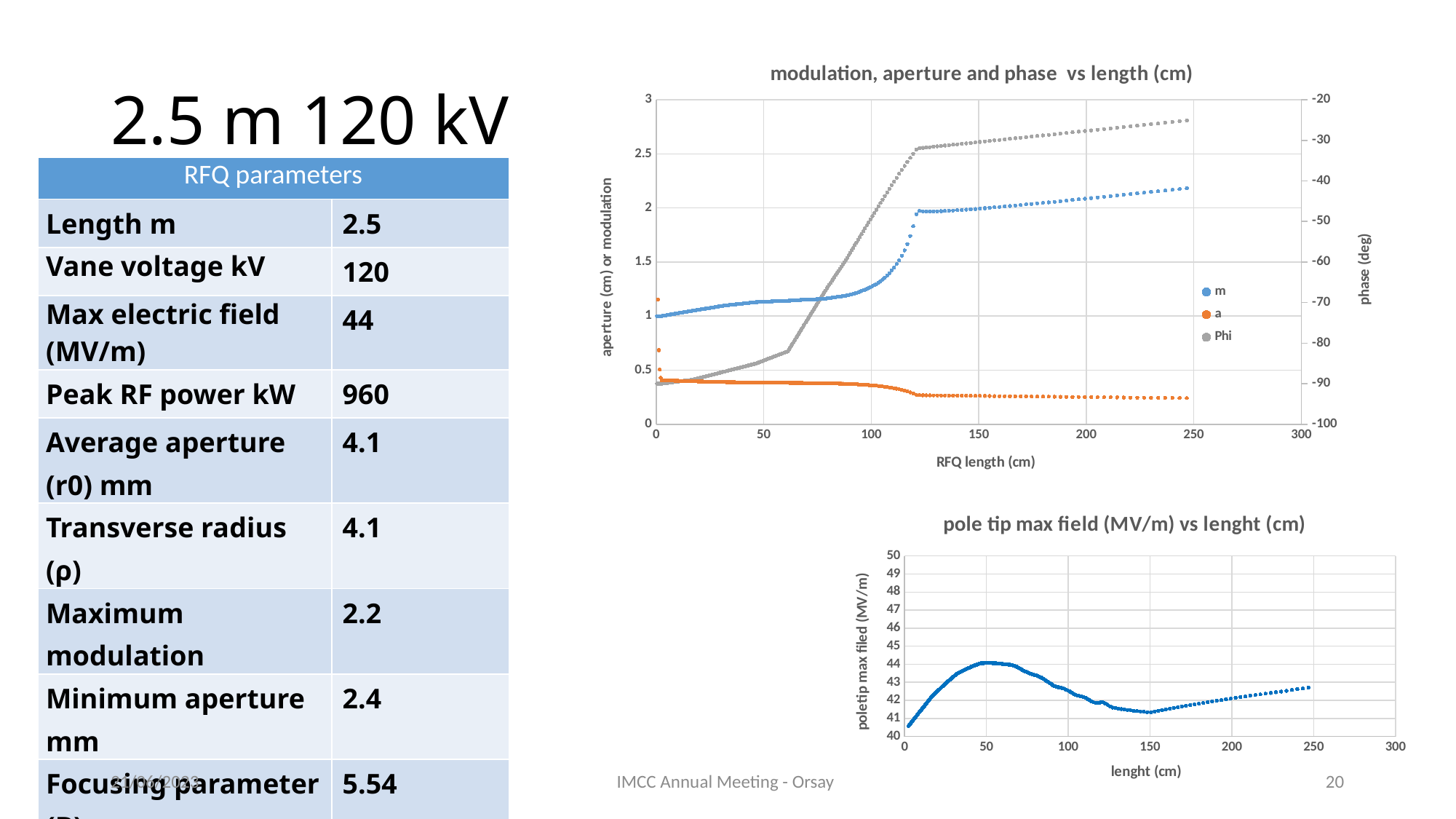
In the top chart (modulation, aperture and phase vs length), is the value of a at 250 cm greater or less than 0.5? less In the top chart (modulation, aperture and phase vs length), does the a series rise or fall as RFQ length increases? fall What kind of chart is the top chart (modulation, aperture and phase vs length)? scatter chart In the top chart (modulation, aperture and phase vs length), how many series does the legend list? 3 In the top chart (modulation, aperture and phase vs length), does the m series rise or fall as RFQ length increases? rise In the top chart (modulation, aperture and phase vs length), is the Phi value at 250 cm greater or less than -30 degrees? greater What is the title of the top chart on the slide? modulation, aperture and phase vs length (cm) What is the title of the bottom chart on the slide? pole tip max field (MV/m) vs lenght (cm) In the top chart (modulation, aperture and phase vs length), is the value of m at 250 cm greater or less than 2? greater In the top chart (modulation, aperture and phase vs length), what are the legend entries? m, a, Phi